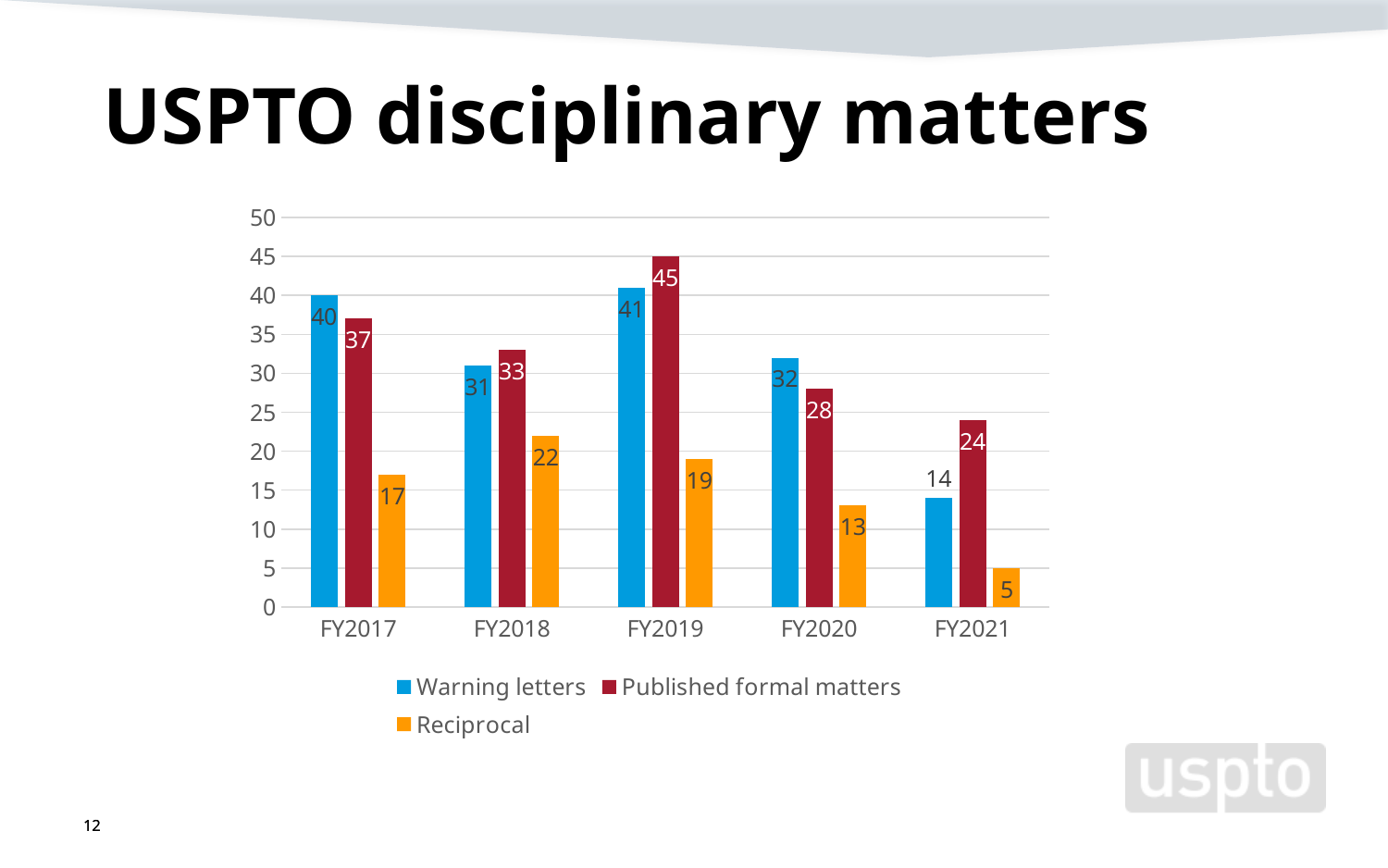
How many fiscal years are shown on the x axis? 5 In which fiscal year was the Reciprocal value lowest? FY2021 What is the value for Published formal matters in FY2021? 24 How many series does the legend list? 3 What kind of chart is shown on the slide? Bar chart Do the Reciprocal values rise or fall from FY2018 to FY2021? Fall What colour represents Reciprocal in the chart? Orange Which is larger in FY2017: Warning letters or Published formal matters? Warning letters In which fiscal year were Published formal matters highest? FY2019 What is the difference between Warning letters and Published formal matters in FY2020? 4 How many Warning letters were there in FY2019? 41 What is the Reciprocal value for FY2018? 22